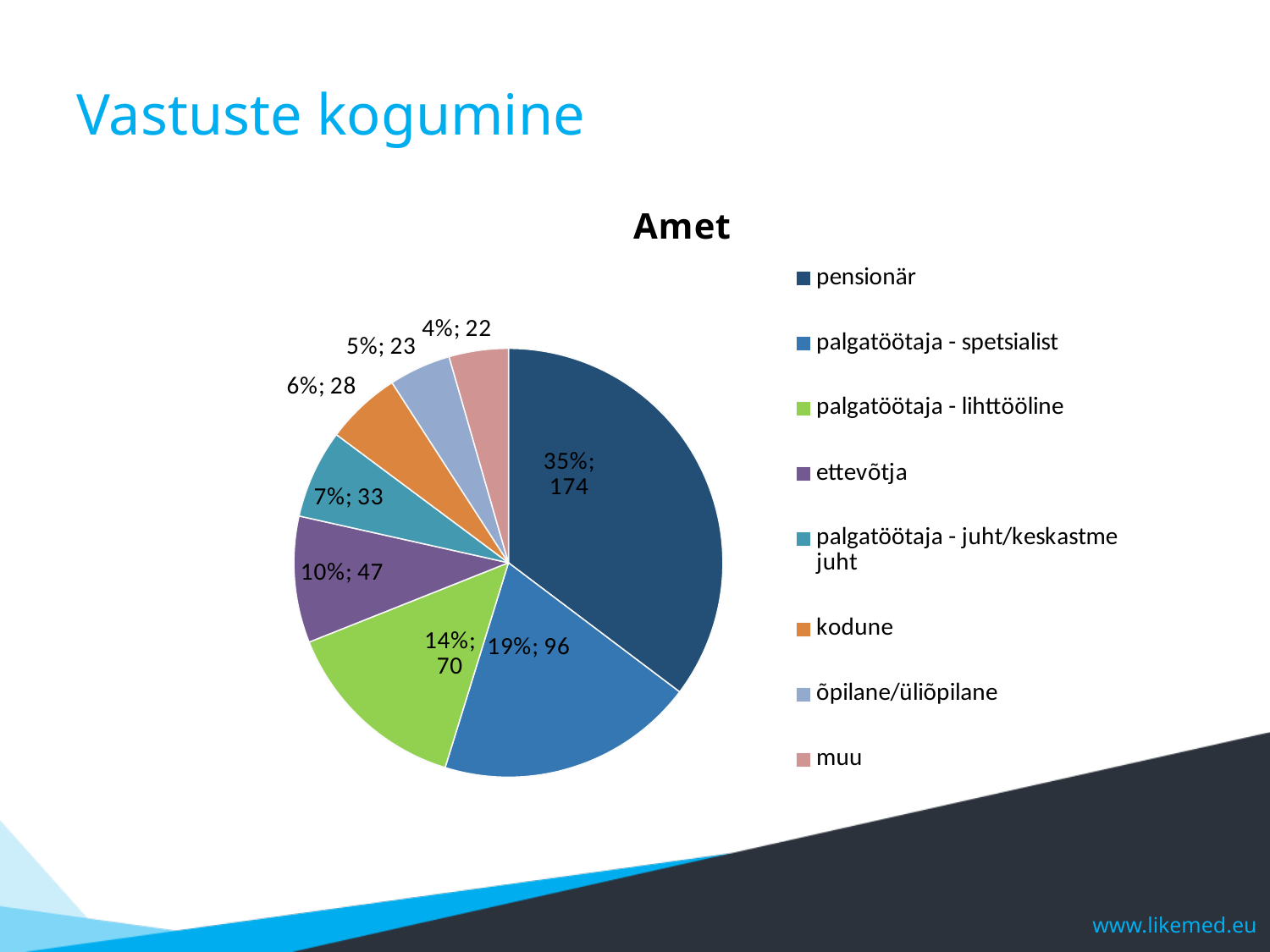
What is the count shown for palgatöötaja - lihttööline? 70 Which category has the largest slice? pensionär What is the count shown for ettevõtja? 47 Which is larger, the count for kodune or the count for õpilane/üliõpilane? kodune Which category has the smallest slice? muu What is the count shown for pensionär? 174 What percentage share does palgatöötaja - juht/keskastme juht have? 7% What is the title of the chart? Amet How many slices does the pie chart have? 8 What is the difference between the counts for pensionär and palgatöötaja - spetsialist? 78 What kind of chart is shown on the slide? pie chart What percentage share does palgatöötaja - spetsialist have? 19%